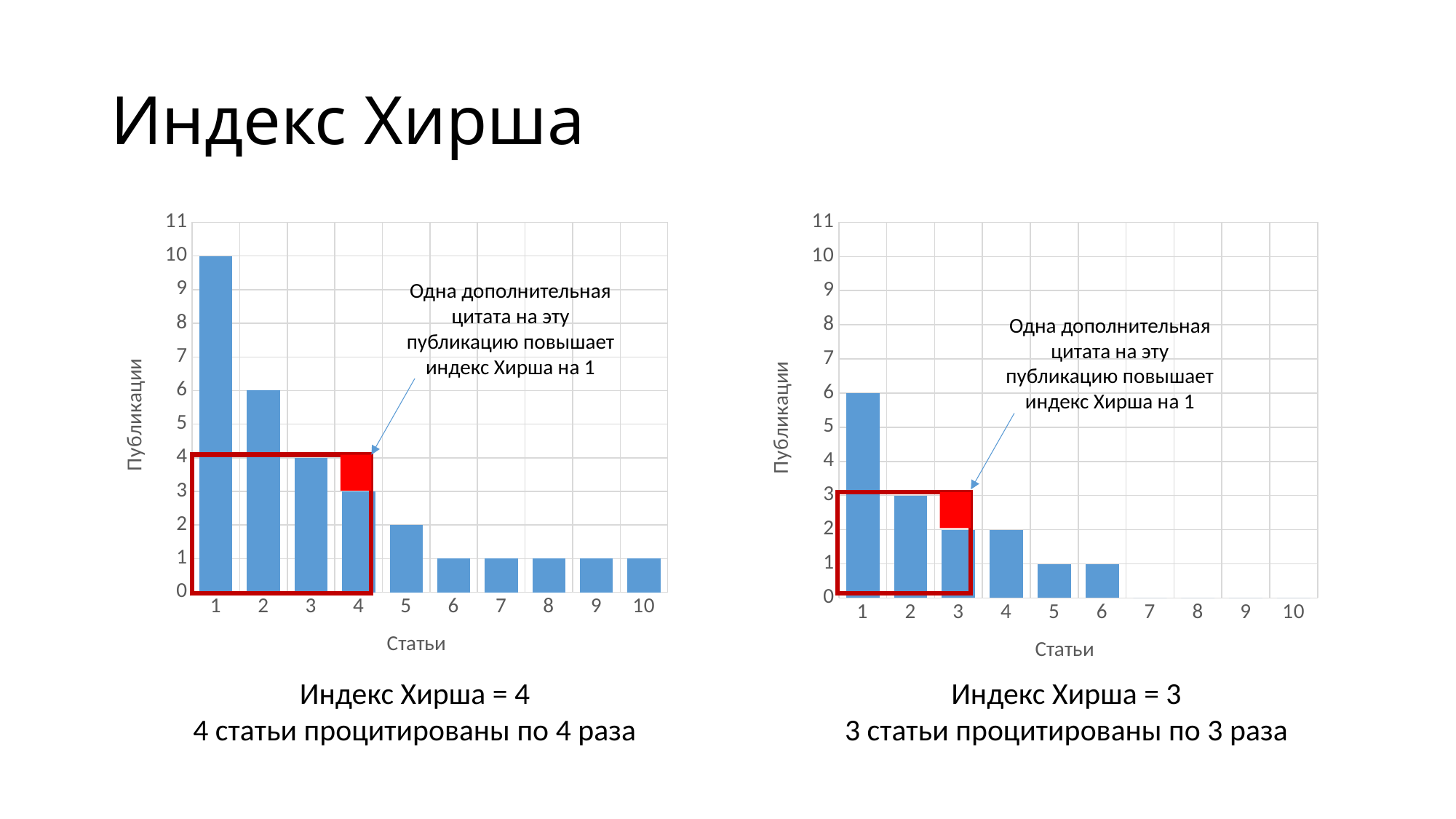
In the left chart (Индекс Хирша = 4), what is the difference between the values for article 1 and article 2? 4 In the right chart (Индекс Хирша = 3), which is larger, the value for article 1 or the value for article 4? Article 1 In the left chart (Индекс Хирша = 4), do the values rise or fall as the article number increases? Fall In the left chart (Индекс Хирша = 4), which article has the highest value? 1 In the left chart (Индекс Хирша = 4), what is the value for article 5? 2 In the right chart (Индекс Хирша = 3), what is the value for article 1? 6 In the right chart (Индекс Хирша = 3), is the value for article 1 greater or less than 5? greater In the right chart (Индекс Хирша = 3), what is the value for article 2? 3 What is the label of the x axis on the left chart (Индекс Хирша = 4)? Статьи What kind of chart is the left chart (Индекс Хирша = 4)? Bar chart In the left chart (Индекс Хирша = 4), what is the value for article 2? 6 In the left chart (Индекс Хирша = 4), what is the value for article 1? 10